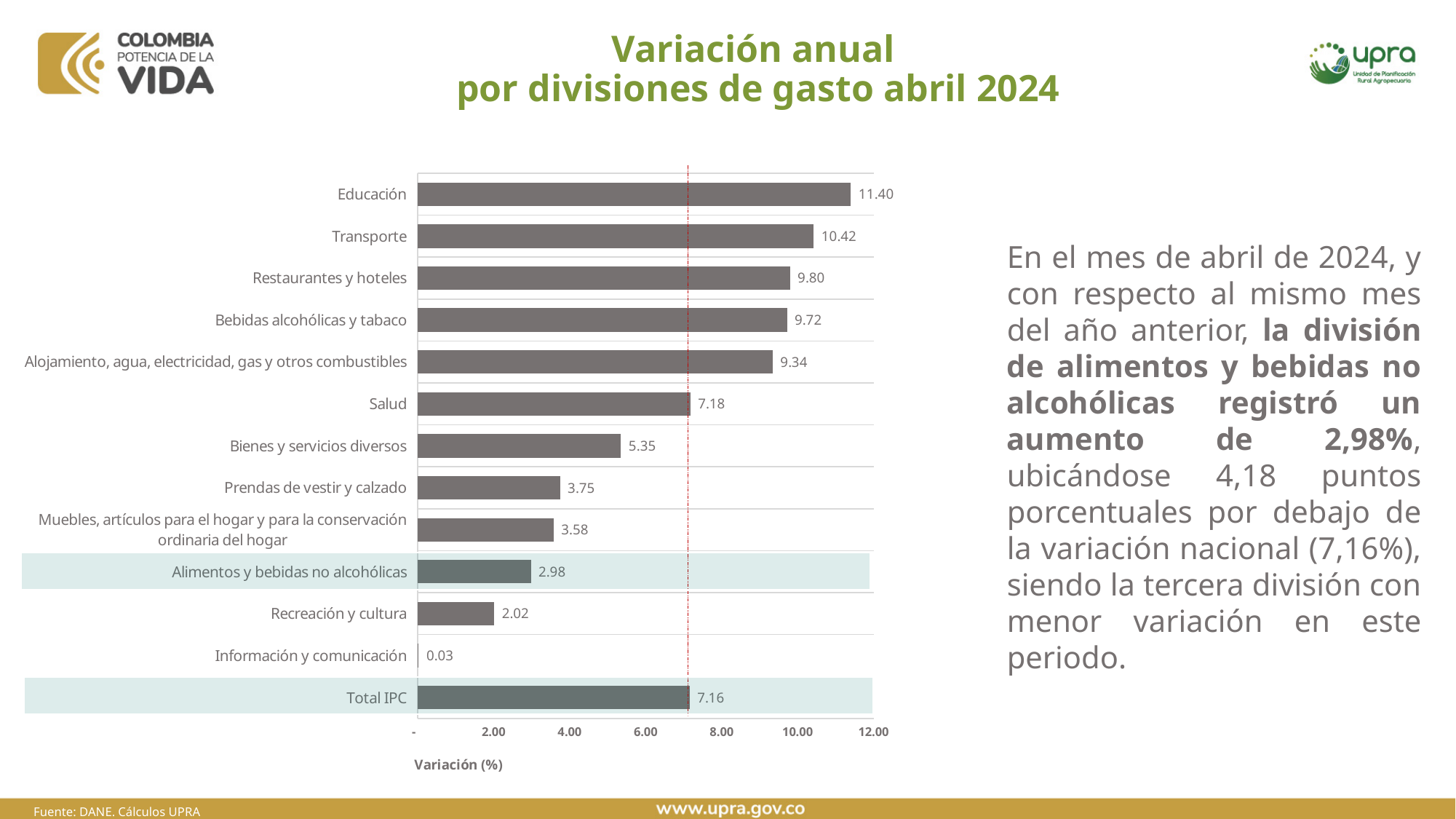
What value is shown for Alimentos y bebidas no alcohólicas? 2.98 What is the difference between the values for Educación and Transporte? 0.98 Which category has the highest value in the chart? Educación What value is shown for Información y comunicación? 0.03 How many bars (categories) are plotted in the chart? 13 What is the label of the horizontal axis of the chart? Variación (%) What value is shown for Total IPC? 7.16 What is the annual variation value shown for Educación? 11.40 What kind of chart is shown on the slide? Bar chart Which category has the lowest value in the chart? Información y comunicación Which has a larger value, Salud or Bienes y servicios diversos? Salud What is the difference between the values for Total IPC and Alimentos y bebidas no alcohólicas? 4.18